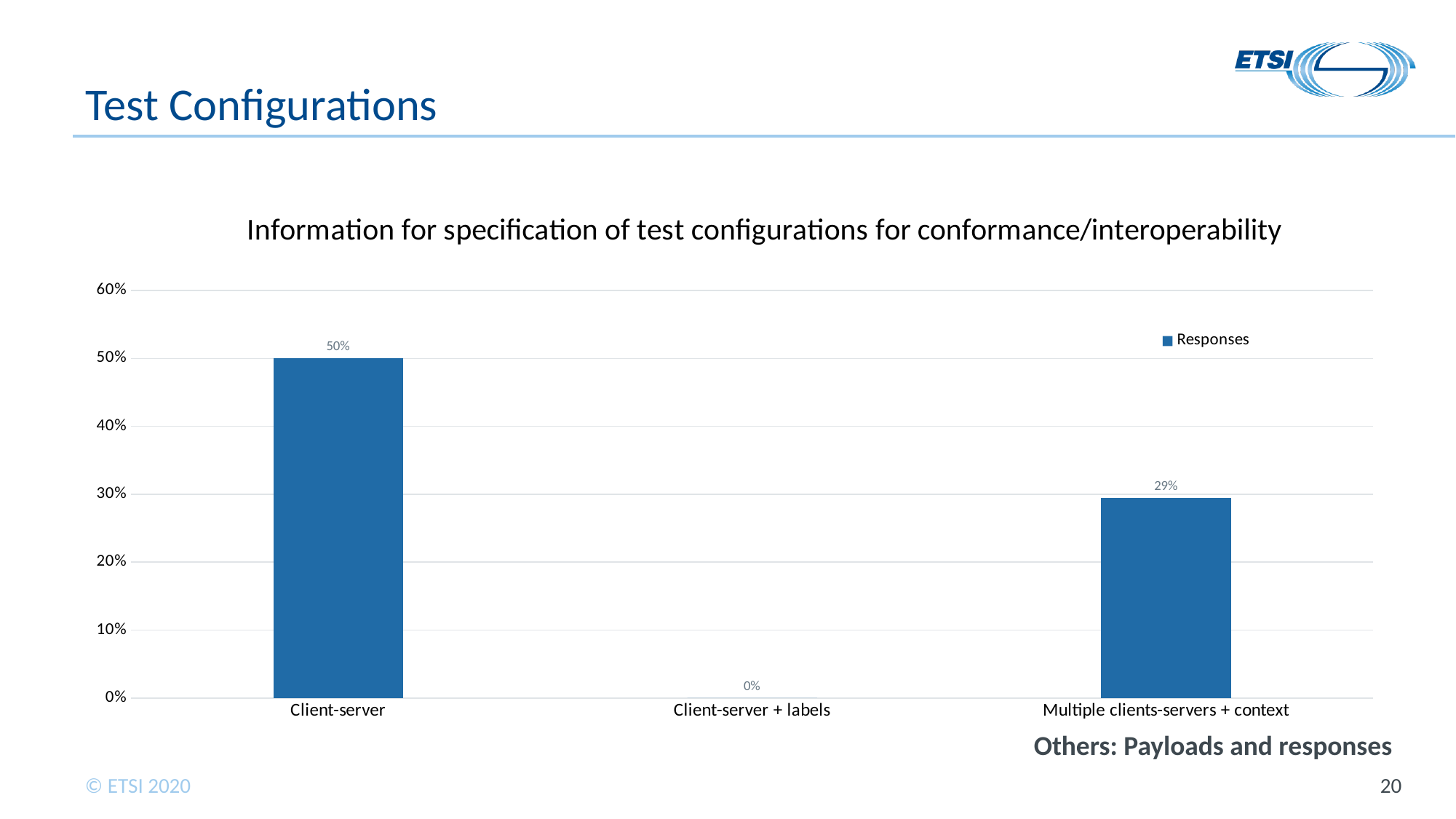
How many categories are shown on the x axis? 3 Is the value for Multiple clients-servers + context greater or less than 30%? less Which category has the lowest value? Client-server + labels Which category has the highest value? Client-server What is the value for Client-server + labels? 0% What is the value for Multiple clients-servers + context? 29% What is the value for Client-server? 50% Which is larger, the value for Client-server or the value for Multiple clients-servers + context? Client-server What is the difference between the values for Client-server and Multiple clients-servers + context? 21% What kind of chart is shown on the slide? bar chart How many series does the legend list? 1 What is the title of the chart? Information for specification of test configurations for conformance/interoperability